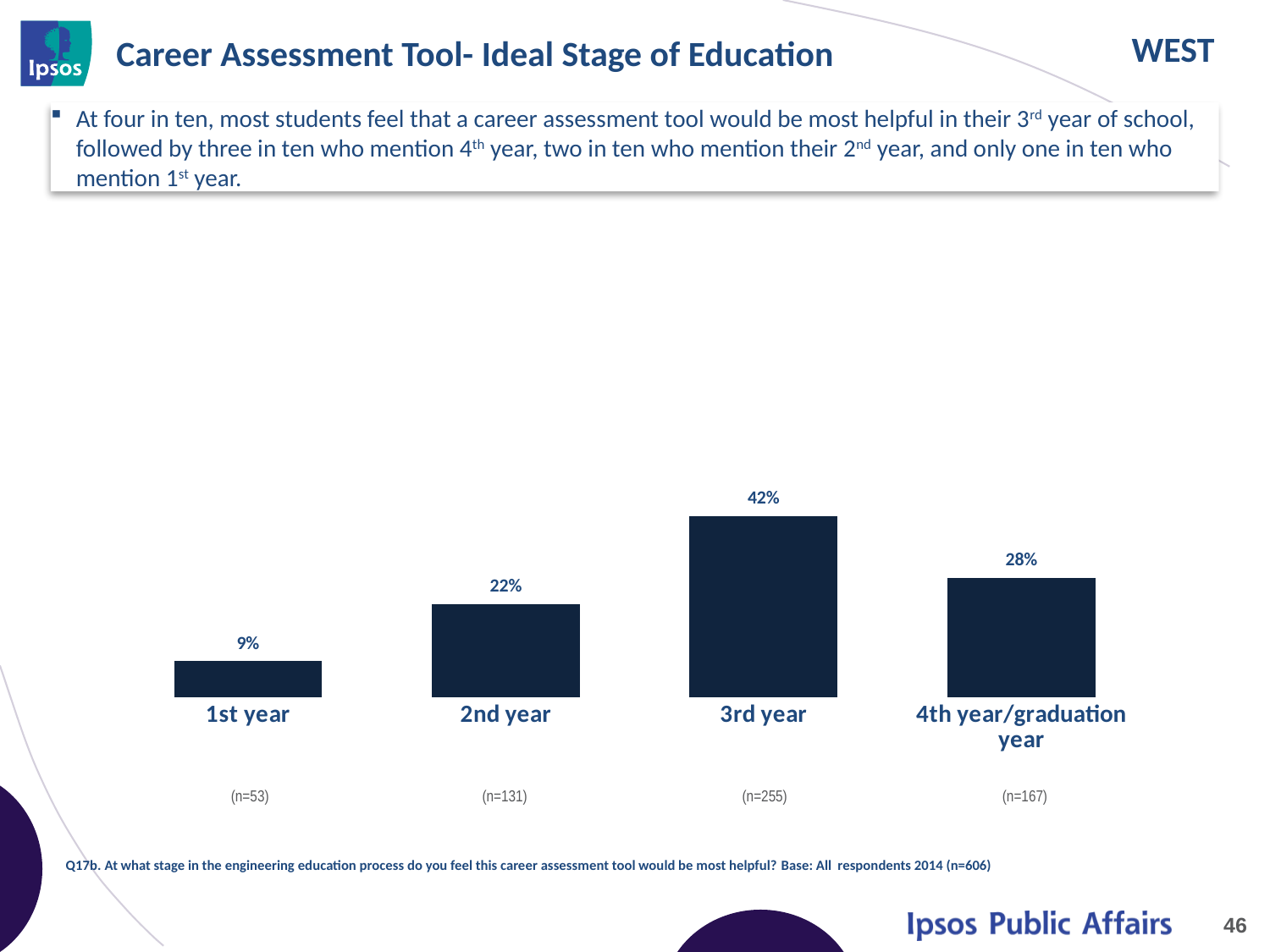
What is the value shown for 4th year/graduation year? 28% What is the difference between the values for 3rd year and 2nd year? 20% Which is larger, the value for 2nd year or the value for 4th year/graduation year? 4th year/graduation year What percentage of students said a career assessment tool would be most helpful in their 3rd year? 42% What kind of chart is shown on the slide? Bar chart Which stage of education has the lowest value? 1st year What is the sample size (n) shown for 1st year? n=53 Which stage of education has the highest value? 3rd year How many stages of education are shown in the chart? 4 What is the value shown for 1st year? 9% What is the difference between the values for 4th year/graduation year and 1st year? 19% What is the sample size (n) shown for 3rd year? n=255